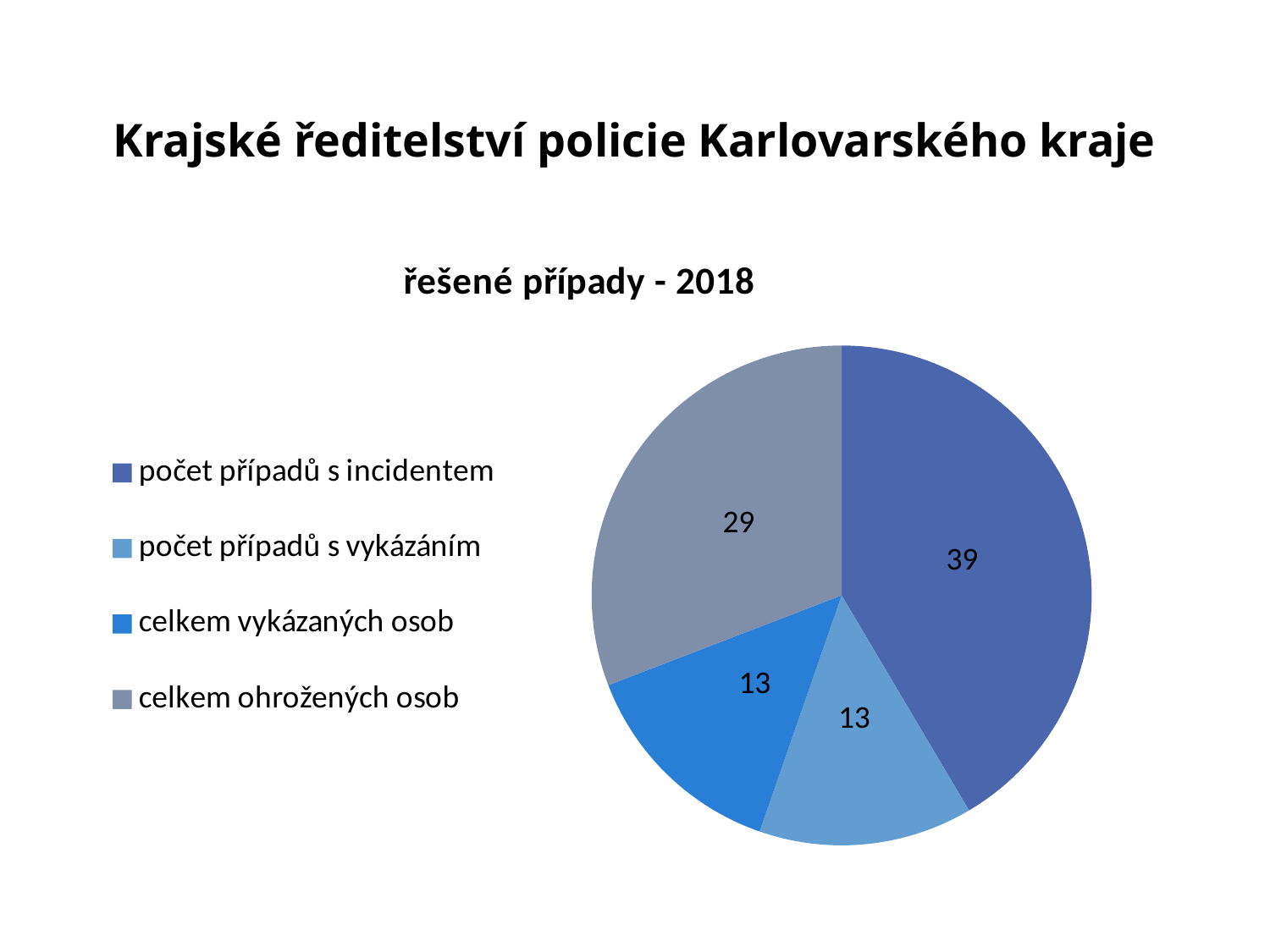
What is the value for "počet případů s incidentem" in the pie chart? 39 What is the difference between the values for "počet případů s incidentem" and "celkem ohrožených osob"? 10 What kind of chart is shown on the slide? pie chart How many categories does the pie chart show? 4 What is the value for "celkem ohrožených osob" in the pie chart? 29 What is the difference between the values for "počet případů s incidentem" and "celkem vykázaných osob"? 26 Which category has the largest slice in the pie chart? počet případů s incidentem What is the title of the chart? řešené případy - 2018 What is the value for "celkem vykázaných osob" in the pie chart? 13 What is the sum of all the values shown in the pie chart? 94 What is the value for "počet případů s vykázáním" in the pie chart? 13 Which is larger: "celkem ohrožených osob" or "počet případů s vykázáním"? celkem ohrožených osob